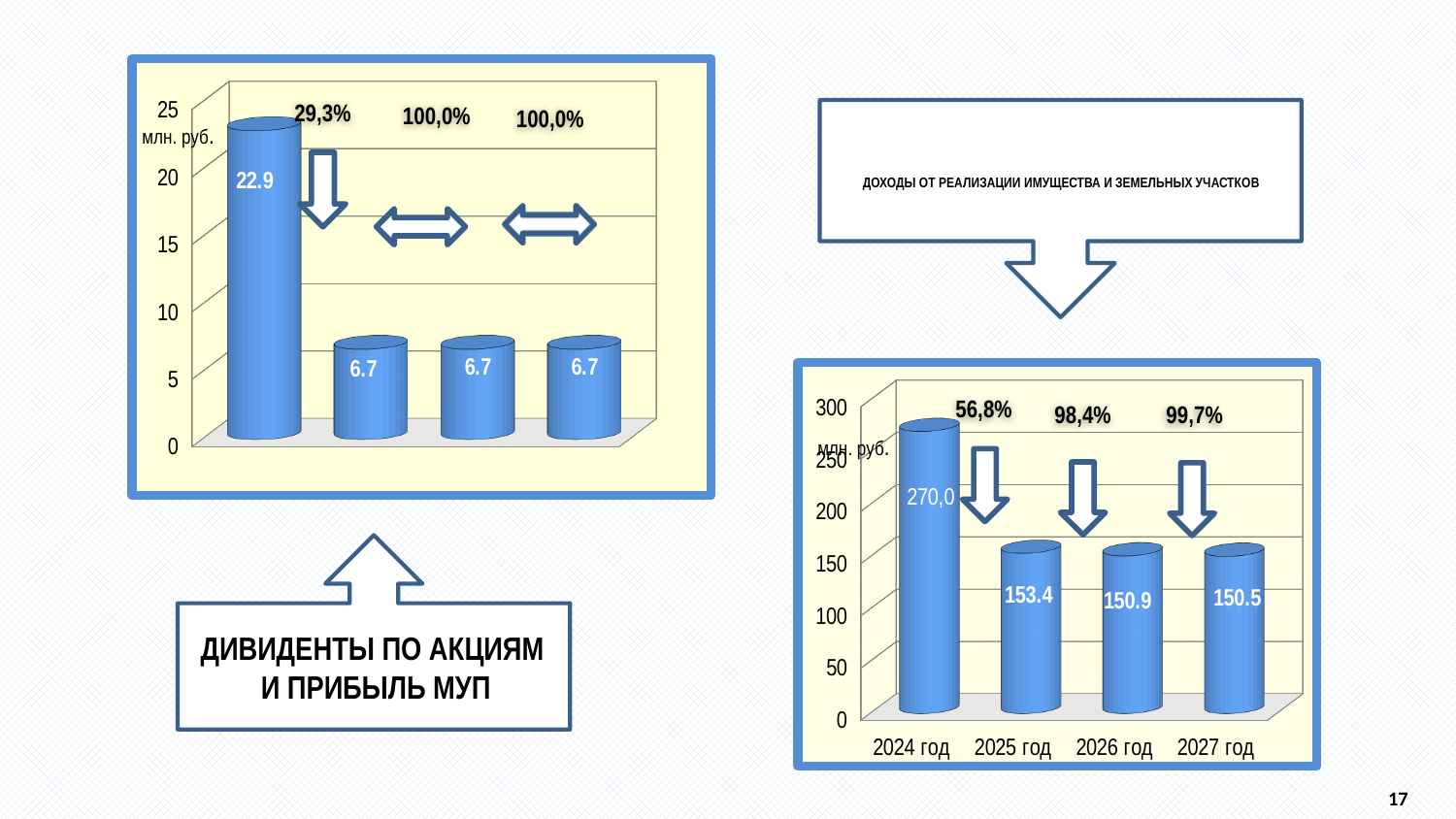
In the chart titled 'Доходы от реализации имущества и земельных участков', which is larger, the value for 2024 год or 2025 год? 2024 год In the chart titled 'Доходы от реализации имущества и земельных участков', what is the difference between the values for 2025 год and 2026 год? 2.5 In the chart titled 'Доходы от реализации имущества и земельных участков', what is the value for 2024 год? 270,0 In the chart on the left of the slide, labelled 'Дивиденты по акциям и прибыль МУП', what is the highest value shown on a bar? 22.9 What kind of chart is the one on the left of the slide, labelled 'Дивиденты по акциям и прибыль МУП'? bar chart In the chart titled 'Доходы от реализации имущества и земельных участков', do the values rise or fall from 2024 год to 2027 год? fall In the chart titled 'Доходы от реализации имущества и земельных участков', what is the value for 2025 год? 153.4 In the chart titled 'Доходы от реализации имущества и земельных участков', how many years are shown on the x axis? 4 In the chart titled 'Доходы от реализации имущества и земельных участков', what is the value for 2027 год? 150.5 In the chart titled 'Доходы от реализации имущества и земельных участков', which year has the highest value? 2024 год How many bars are in the chart on the left of the slide, labelled 'Дивиденты по акциям и прибыль МУП'? 4